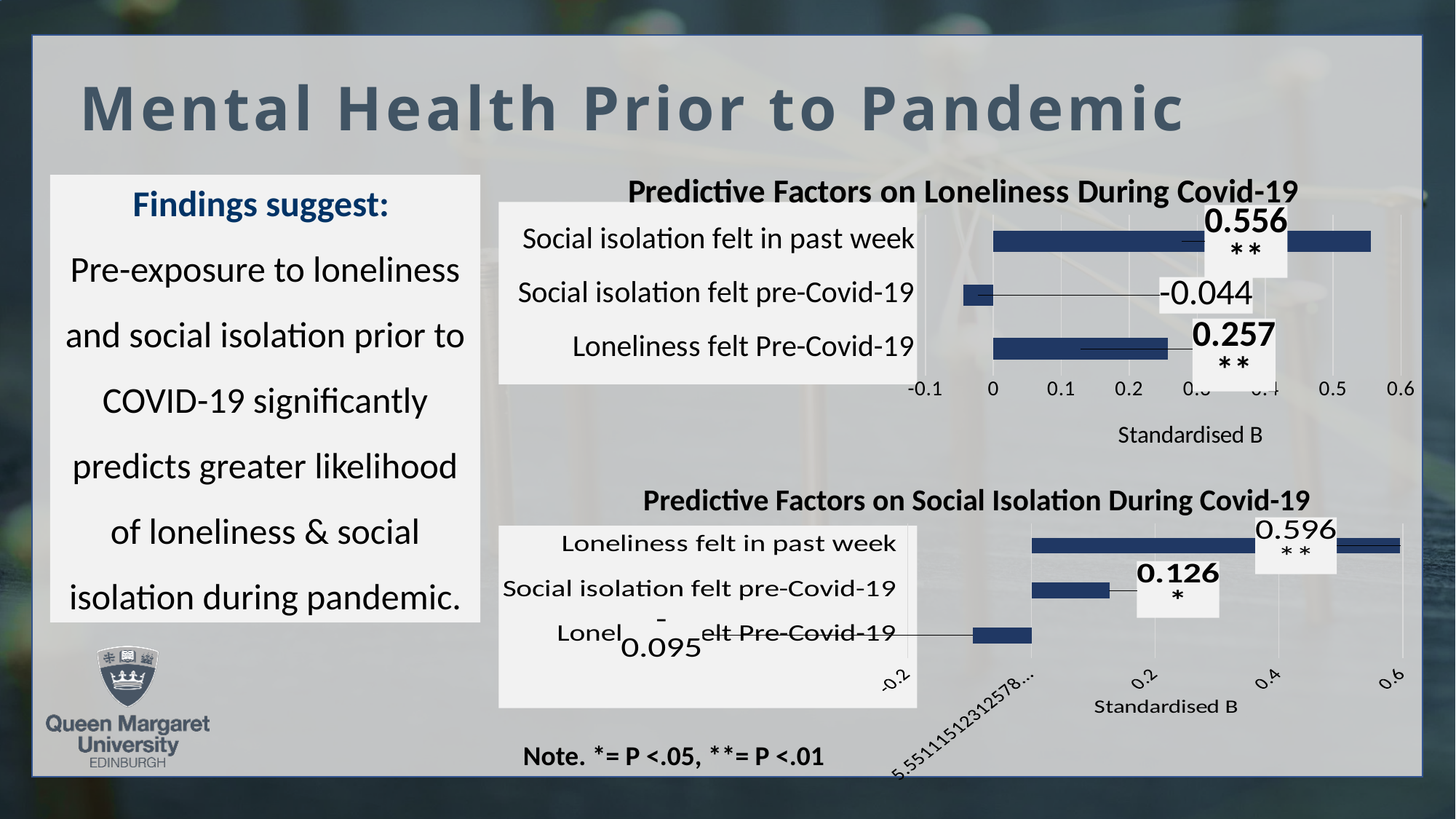
In the 'Predictive Factors on Loneliness During Covid-19' chart, which factor has the lowest standardised B? Social isolation felt pre-Covid-19 In the 'Predictive Factors on Social Isolation During Covid-19' chart, what is the value for 'Social isolation felt pre-Covid-19'? 0.126 What type of chart is the 'Predictive Factors on Social Isolation During Covid-19' chart? Bar chart In the 'Predictive Factors on Social Isolation During Covid-19' chart, is the value for 'Loneliness felt in past week' greater or less than 0.4? greater In the 'Predictive Factors on Loneliness During Covid-19' chart, what is the value for 'Loneliness felt Pre-Covid-19'? 0.257 In the 'Predictive Factors on Social Isolation During Covid-19' chart, what is the value for 'Loneliness felt in past week'? 0.596 In the 'Predictive Factors on Loneliness During Covid-19' chart, what is the value for 'Social isolation felt pre-Covid-19'? -0.044 In the 'Predictive Factors on Social Isolation During Covid-19' chart, which factor has the highest standardised B? Loneliness felt in past week How many factors are plotted in the 'Predictive Factors on Loneliness During Covid-19' chart? 3 In the 'Predictive Factors on Loneliness During Covid-19' chart, what is the standardised B value for 'Social isolation felt in past week'? 0.556 In the 'Predictive Factors on Loneliness During Covid-19' chart, which factor has the highest standardised B? Social isolation felt in past week In the 'Predictive Factors on Loneliness During Covid-19' chart, what is the difference between the values for 'Social isolation felt in past week' and 'Loneliness felt Pre-Covid-19'? 0.299